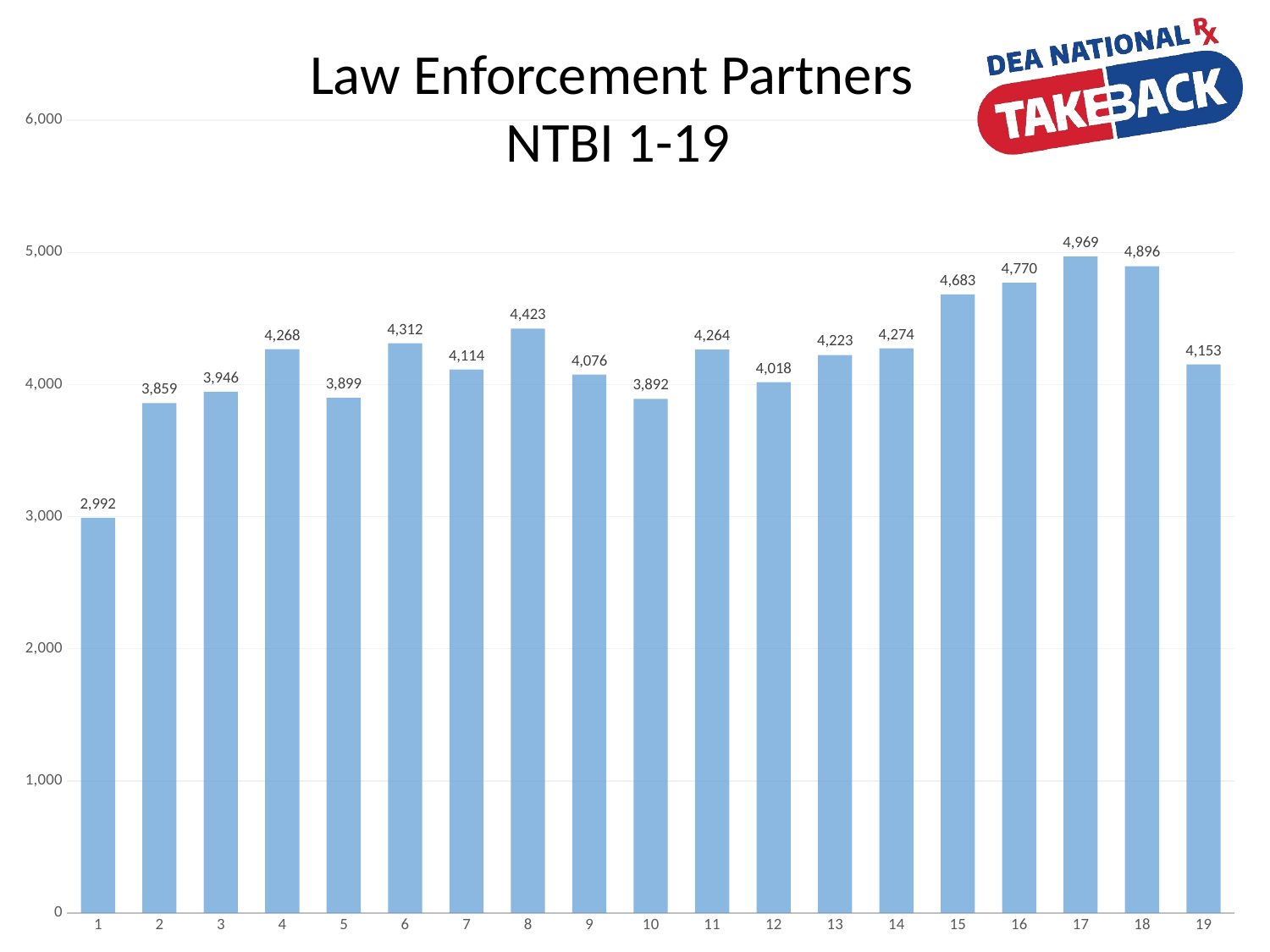
Which is larger, the value for NTBI 8 or the value for NTBI 9? NTBI 8 Is the value for NTBI 10 greater or less than 4,000? less How many NTBI events are shown on the chart? 19 Which NTBI has the highest number of law enforcement partners? 17 What is the difference between the values for NTBI 17 and NTBI 18? 73 Which NTBI has the lowest number of law enforcement partners? 1 What is the value for NTBI 1? 2,992 What kind of chart is shown on the slide? bar chart What is the difference between the values for NTBI 1 and NTBI 2? 867 What is the title of the chart? Law Enforcement Partners NTBI 1-19 What is the value for NTBI 19? 4,153 What is the value for NTBI 17? 4,969